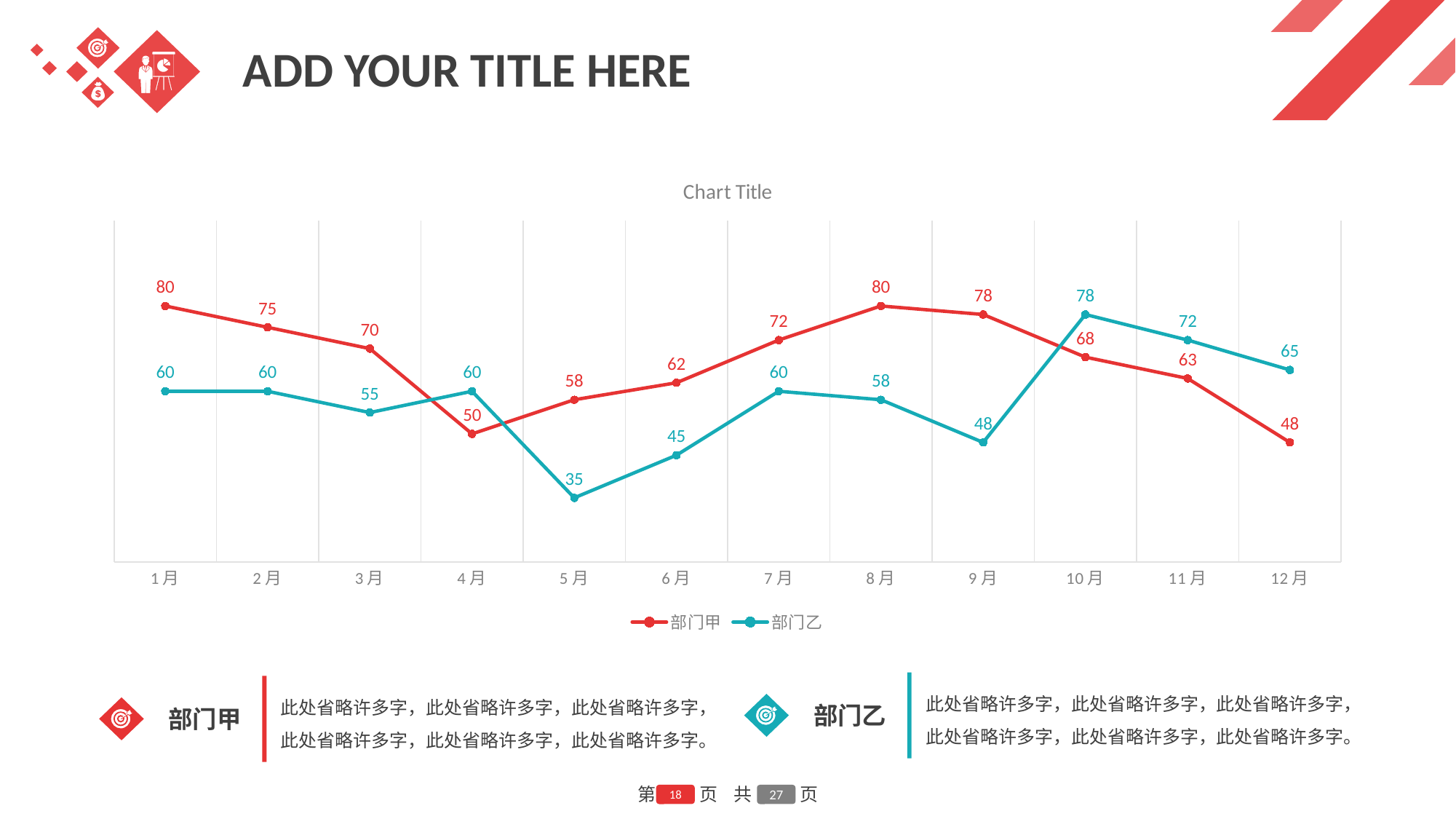
How many series does the legend list? 2 How many months are plotted along the x axis? 12 What kind of chart is shown on the slide? line chart What is the value for 部门乙 in 5月? 35 In which month does 部门乙 reach its highest value? 10月 In which month does 部门甲 have its lowest value? 12月 Does the value for 部门甲 rise or fall from 8月 to 12月? fall Which series has the larger value in 11月, 部门甲 or 部门乙? 部门乙 What is the value for 部门乙 in 10月? 78 What is the difference between 部门甲 and 部门乙 in 5月? 23 What is the value for 部门甲 in 4月? 50 In which month does 部门乙 reach its lowest value? 5月